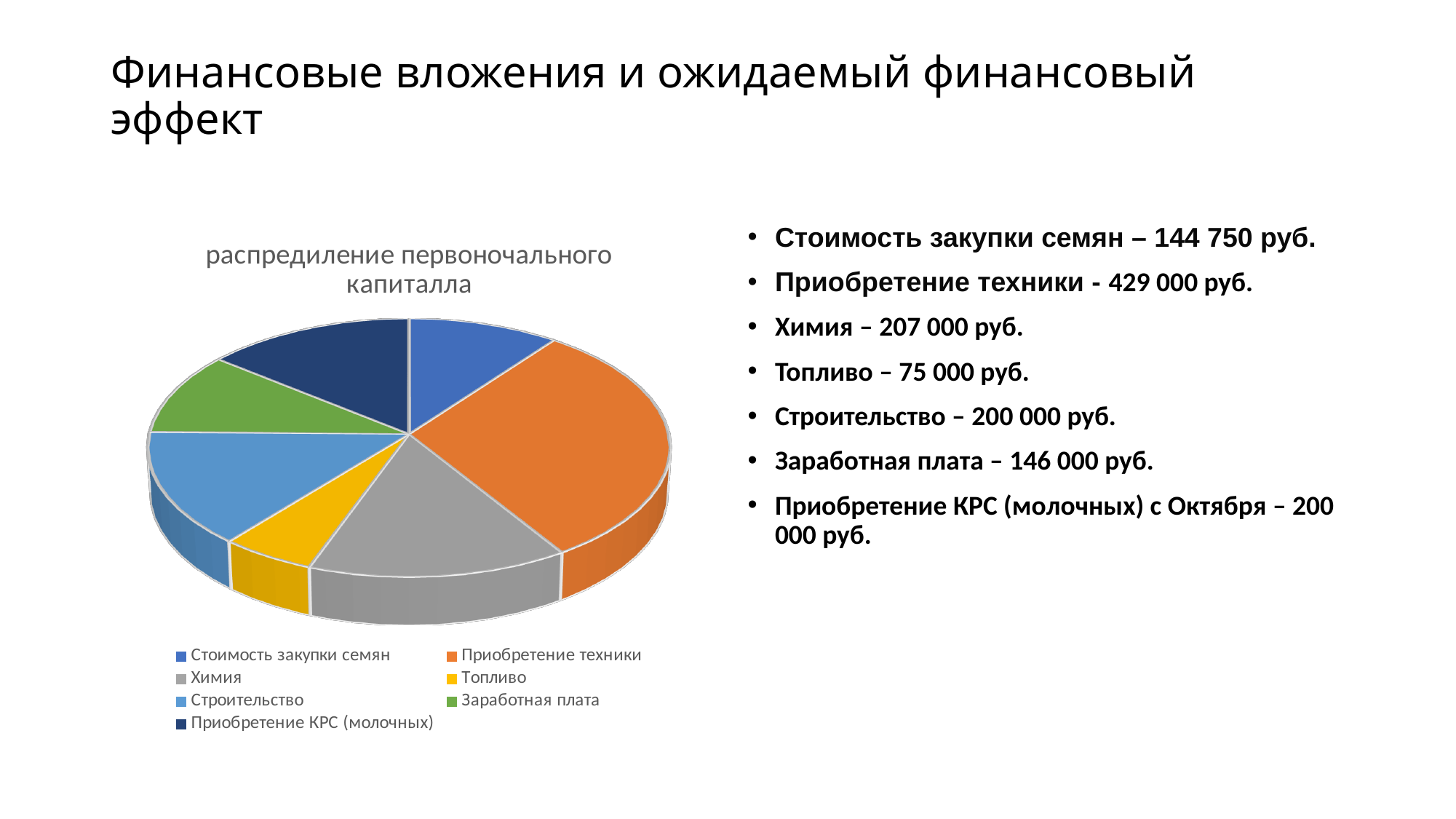
What colour is the slice for Химия in the pie chart? Gray Which category has the largest slice in the pie chart? Приобретение техники How many entries does the legend of the pie chart list? 7 What is the value for Стоимость закупки семян? 144 750 руб. Which is larger, Строительство or Заработная плата? Строительство What is the title of the pie chart? распредиление первоночального капиталла What is the difference between Приобретение техники and Химия? 222 000 руб. What is the value for Приобретение техники? 429 000 руб. What is the value for Топливо? 75 000 руб. What kind of chart is shown on the slide? Pie chart Which category has the smallest slice in the pie chart? Топливо How many slices does the pie chart have? 7